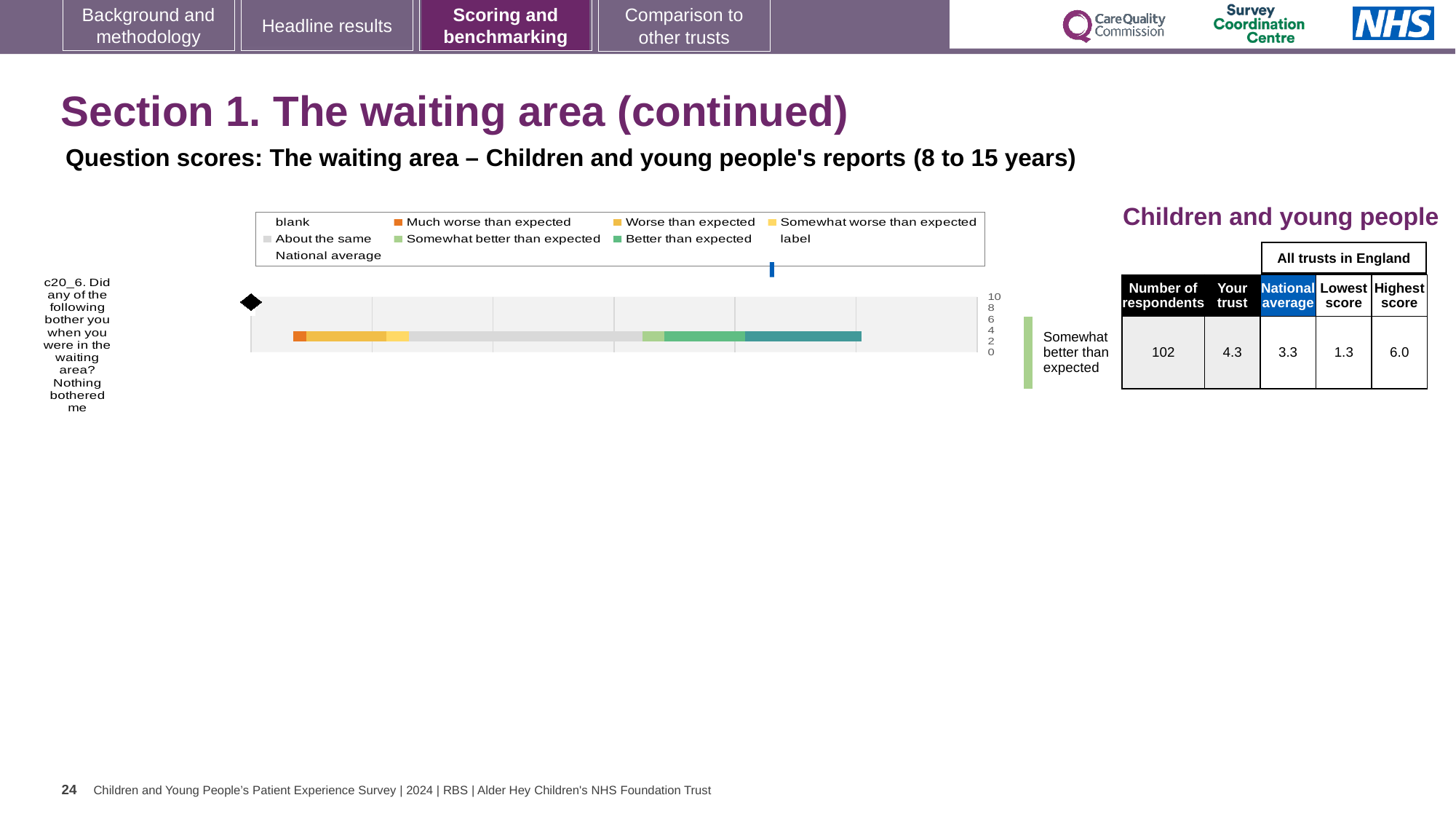
What is the National average score for question c20_6? 3.3 Which is larger for question c20_6, the Your trust score or the National average? Your trust What is the difference between the Highest score and the Lowest score for question c20_6? 4.7 What is the score for Your trust on question c20_6? 4.3 What is the Highest score among all trusts in England for question c20_6? 6.0 What is the difference between the Your trust score and the National average for question c20_6? 1.0 Which benchmark category is the trust's result for question c20_6 placed in? Somewhat better than expected How many questions (categories) are plotted on the chart? 1 Is the Your trust score for question c20_6 greater or less than 4? greater What is the Lowest score among all trusts in England for question c20_6? 1.3 What kind of chart is shown on the slide? bar chart How many respondents answered question c20_6? 102